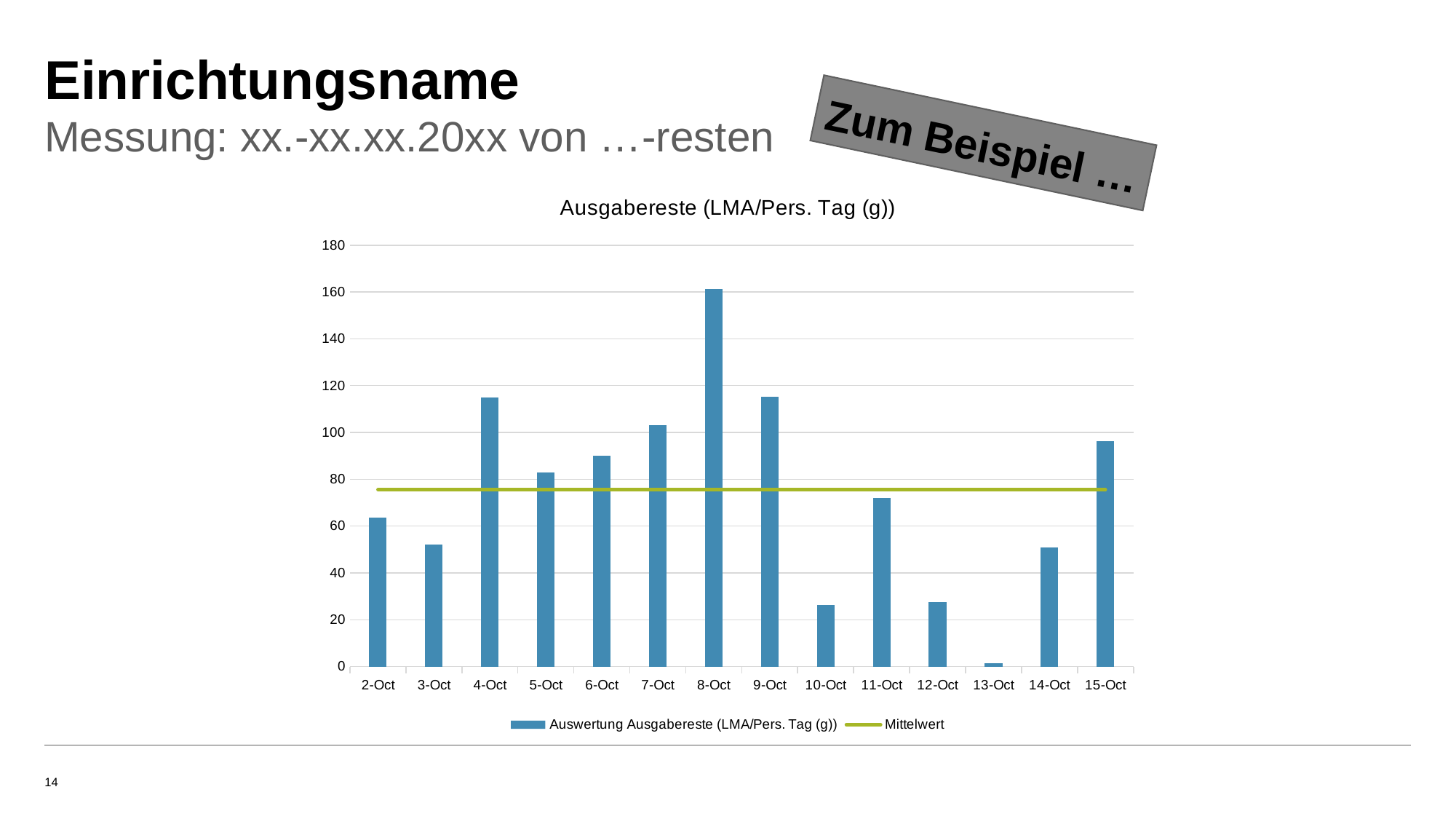
What is the title of the chart? Ausgabereste (LMA/Pers. Tag (g)) Which date has the highest bar? 8-Oct How many series does the legend list? 2 What is the name of the series drawn as a horizontal line in the chart? Mittelwert Is the value for 4-Oct greater or less than 100? greater What kind of chart is shown on the slide? bar chart Which date has the lowest bar? 13-Oct Which is larger, the bar for 7-Oct or the bar for 6-Oct? 7-Oct Is the value for 10-Oct greater or less than 40? less Is the value for 13-Oct greater or less than 20? less How many dates are shown on the x axis of the chart? 14